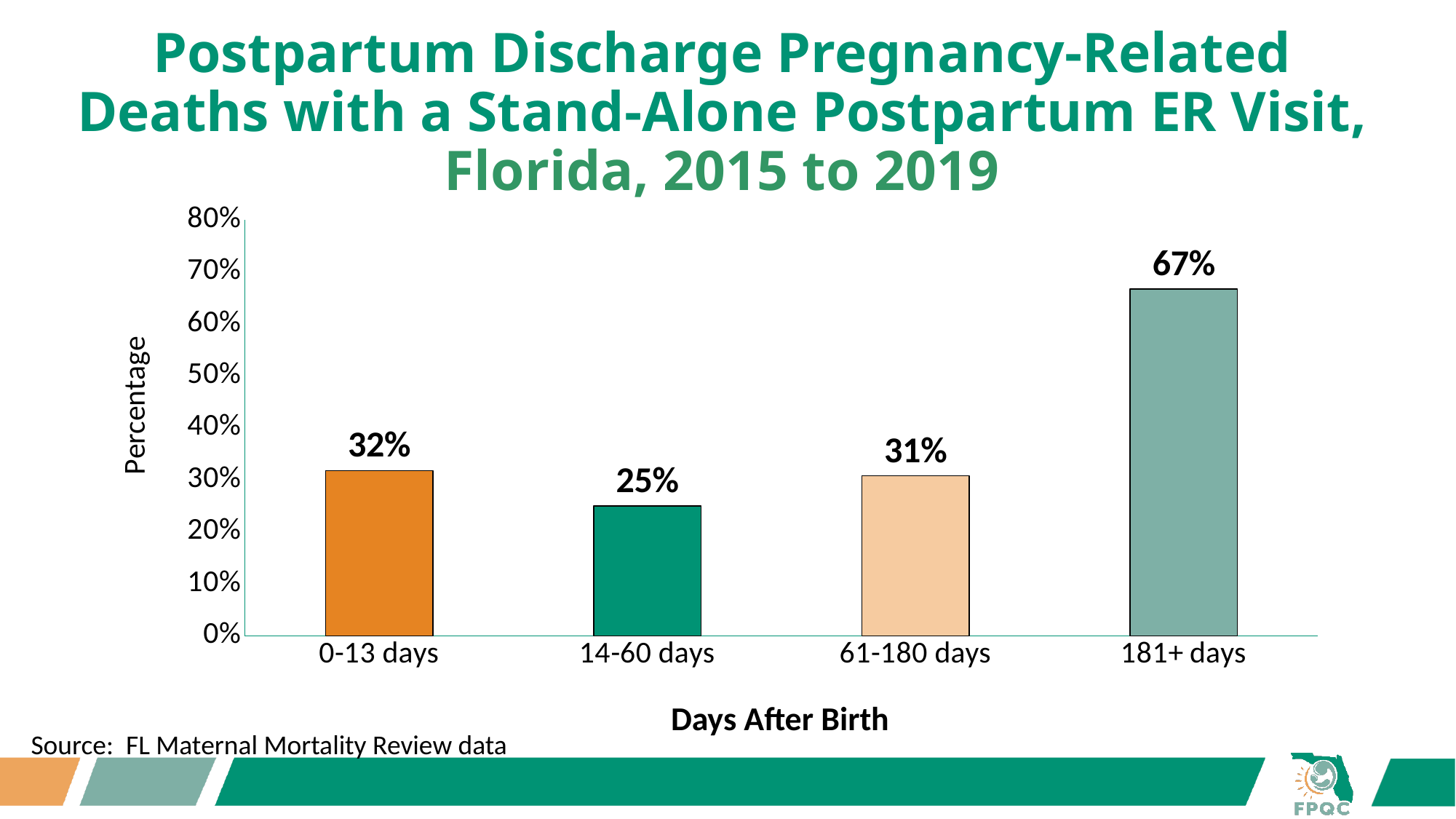
Which days-after-birth category has the highest percentage? 181+ days What is the percentage for 0-13 days? 32% Is the value for 181+ days greater or less than 60%? greater What is the label of the x axis? Days After Birth How many days-after-birth categories are shown on the chart? 4 What is the percentage for 181+ days? 67% What is the difference in percentage points between 181+ days and 0-13 days? 35 What is the percentage for 14-60 days? 25% Which has a higher percentage, 0-13 days or 14-60 days? 0-13 days What is the percentage for 61-180 days? 31% What kind of chart is shown on the slide? Bar chart Which days-after-birth category has the lowest percentage? 14-60 days